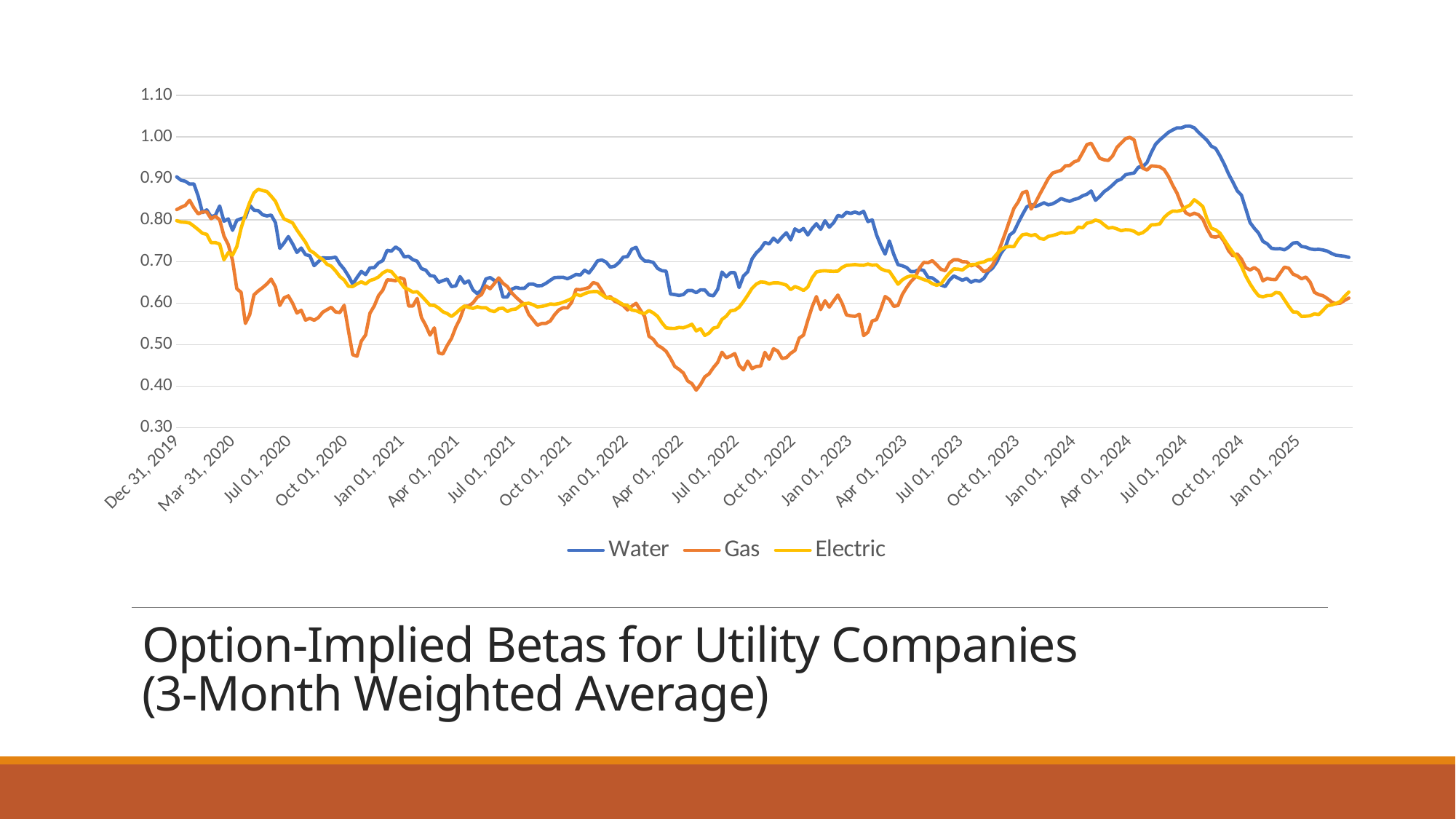
What are the three series named in the legend? Water, Gas, Electric Which series reaches the lowest value anywhere on the chart? Gas How many series does the legend list? 3 At Jul 01, 2022, which is larger, Water or Gas? Water Is the value for Gas at Jul 01, 2022 greater or less than 0.50? less What is the title of the chart? Option-Implied Betas for Utility Companies (3-Month Weighted Average) What kind of chart is shown on the slide? Line chart Is the value for Gas at Apr 01, 2024 greater or less than 0.90? greater At Jul 01, 2020, which is larger, Electric or Gas? Electric Does the Water series rise or fall between Jul 01, 2024 and Jan 01, 2025? Fall Is the peak value of Water around Jul 01, 2024 greater or less than 1.00? greater